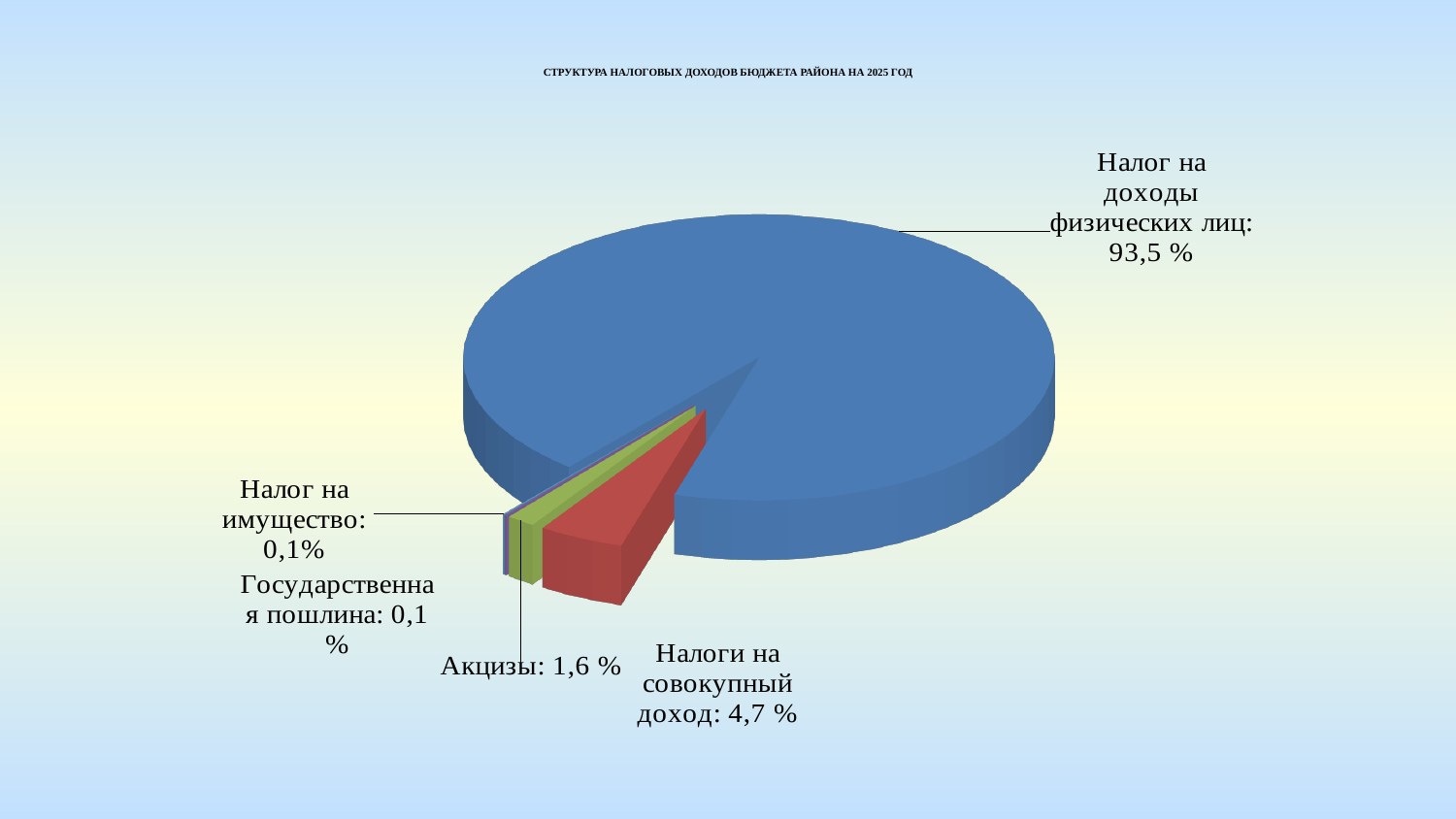
What is the share of Налог на имущество? 0,1% What is the title of the chart? СТРУКТУРА НАЛОГОВЫХ ДОХОДОВ БЮДЖЕТА РАЙОНА НА 2025 ГОД What is the share of Налог на доходы физических лиц in the pie chart? 93,5 % What colour is the slice for Налог на доходы физических лиц? blue By how many percentage points does Налог на доходы физических лиц exceed Налоги на совокупный доход? 88,8 What kind of chart is shown on the slide? pie chart What is the share of Акцизы? 1,6 % What is the share of Государственная пошлина? 0,1 % Which is larger: Налоги на совокупный доход or Акцизы? Налоги на совокупный доход Which category has the largest share of the pie? Налог на доходы физических лиц How many slices does the pie chart have? 5 What is the share of Налоги на совокупный доход? 4,7 %